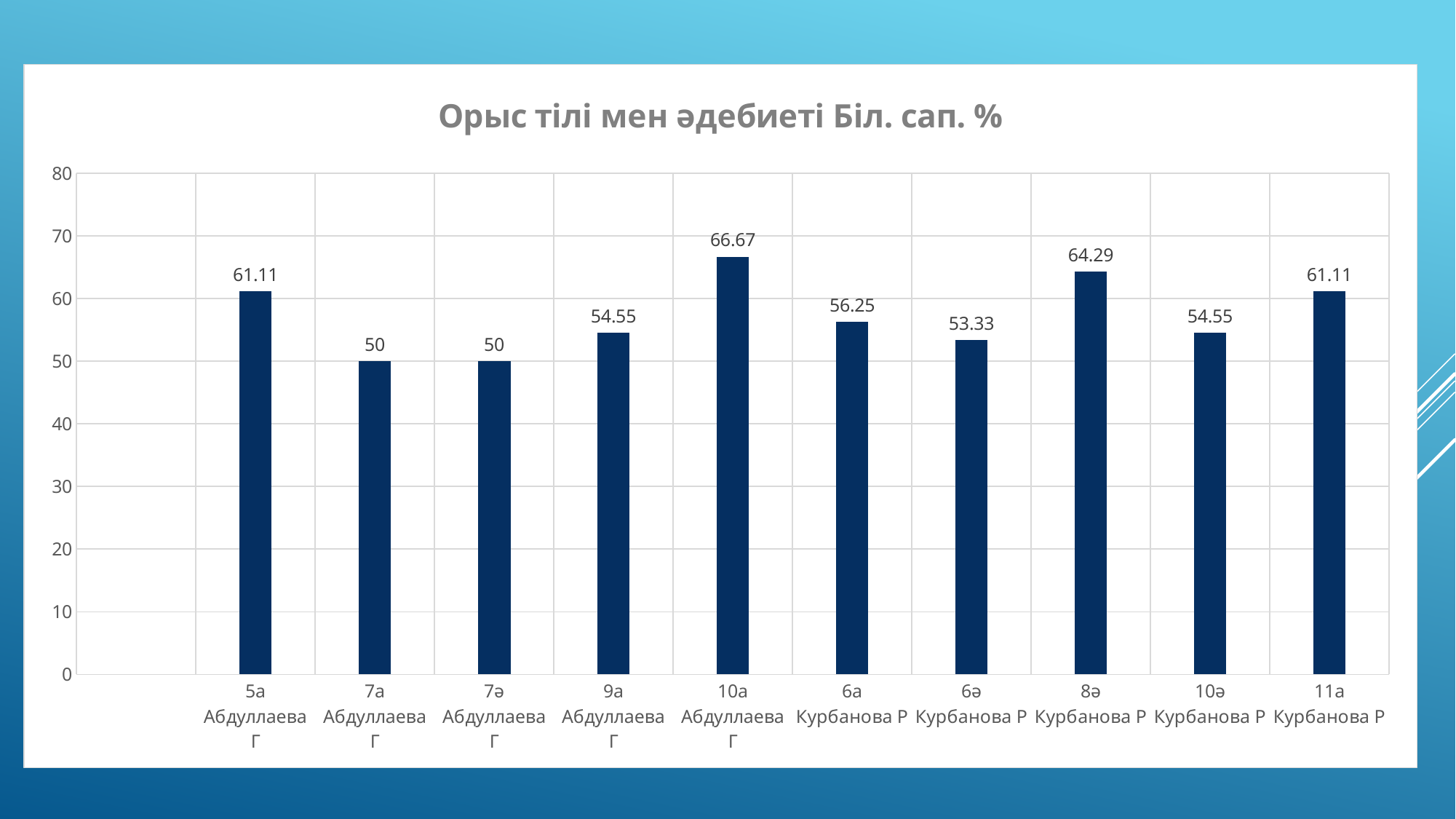
What is the value for 6ә Курбанова Р? 53.33 What is the difference between the values for 5а Абдуллаева Г and 7а Абдуллаева Г? 11.11 How many bars are shown in the chart? 10 What is the difference between the values for 10а Абдуллаева Г and 6а Курбанова Р? 10.42 What is the title of the chart? Орыс тілі мен әдебиеті Біл. сап. % What is the value for 10ә Курбанова Р? 54.55 Which category has the highest value? 10а Абдуллаева Г Which is larger, the value for 9а Абдуллаева Г or the value for 6ә Курбанова Р? 9а Абдуллаева Г What kind of chart is shown on the slide? bar chart What is the value for 10а Абдуллаева Г? 66.67 What is the value for 8ә Курбанова Р? 64.29 Is the value for 8ә Курбанова Р greater or less than 60? greater